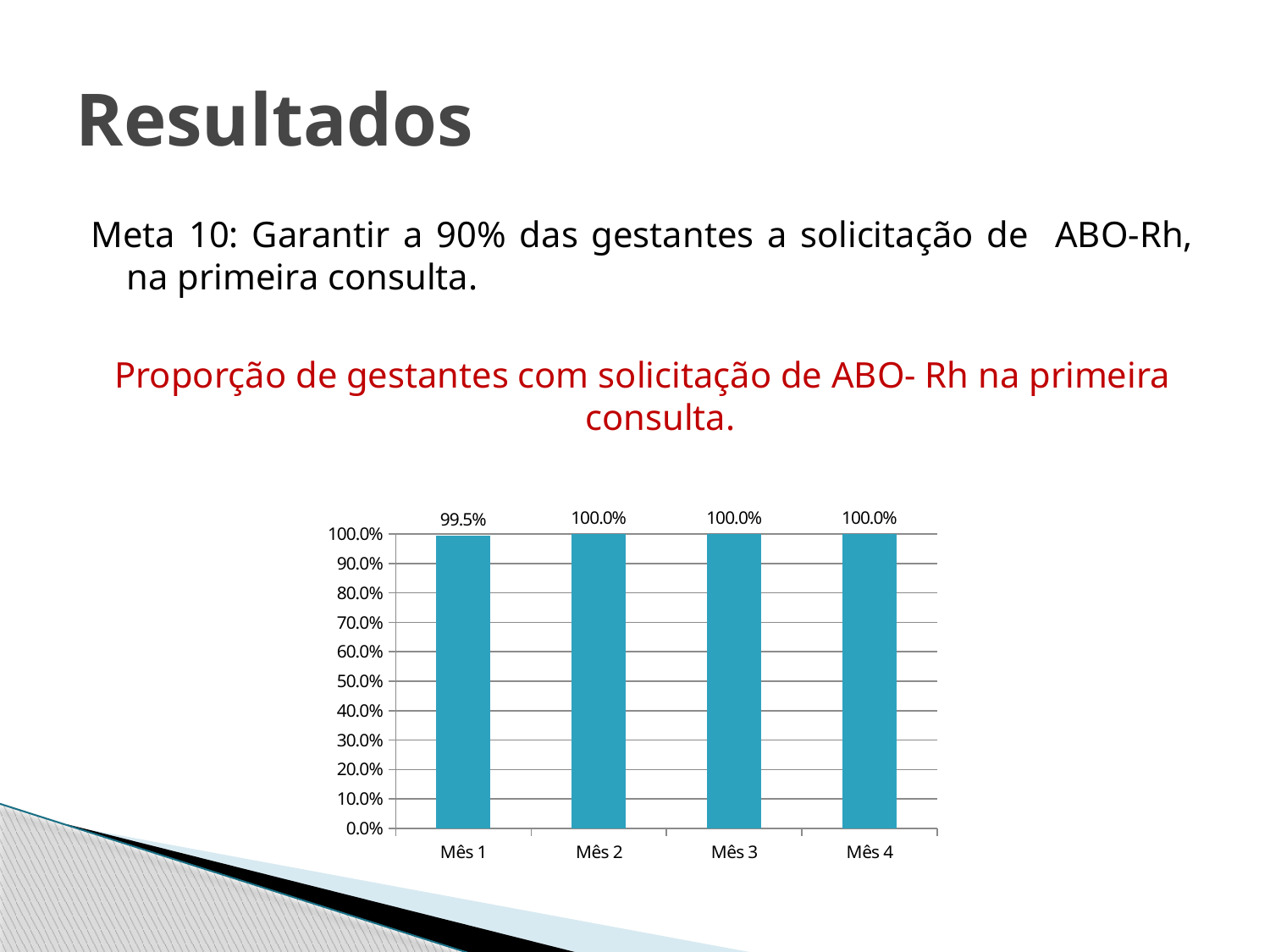
How many months are shown on the x axis? 4 What is the value for Mês 2? 100.0% What is the highest value shown on the y axis? 100.0% What is the value for Mês 4? 100.0% Which month has the lowest value? Mês 1 What is the value for Mês 1? 99.5% Do the values rise or fall from Mês 1 to Mês 2? Rise What is the title of the chart? Proporção de gestantes com solicitação de ABO- Rh na primeira consulta. What is the difference between the values for Mês 2 and Mês 1? 0.5% Is the value for Mês 3 greater or less than 90.0%? greater What kind of chart is shown on the slide? Bar chart Is the value for Mês 1 greater or less than 50.0%? greater